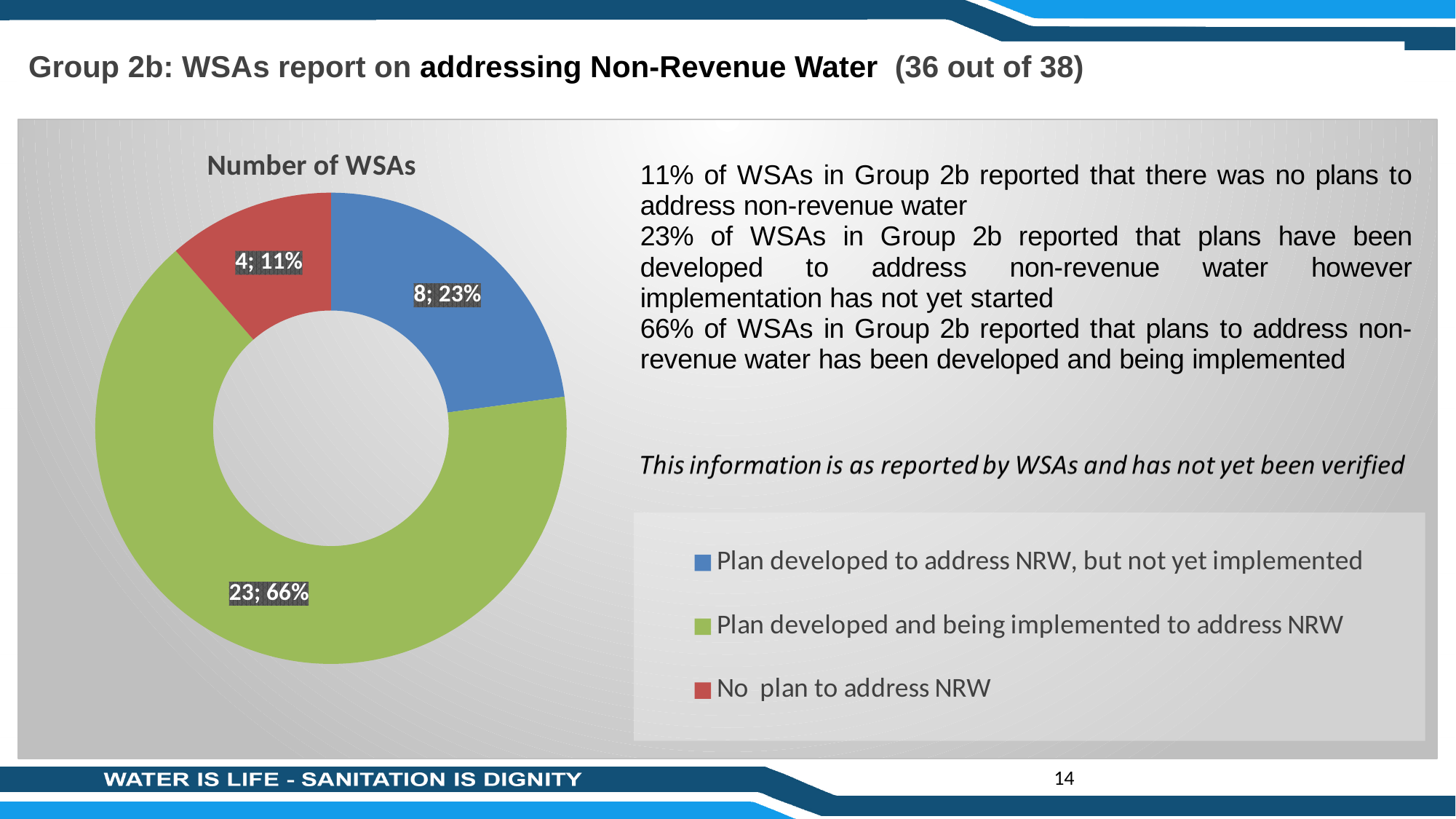
What is the title of the chart? Number of WSAs What is the difference in number of WSAs between 'Plan developed and being implemented to address NRW' and 'Plan developed to address NRW, but not yet implemented'? 15 How many categories does the chart show? 3 What share of the chart does 'No plan to address NRW' represent? 11% How many WSAs reported 'Plan developed to address NRW, but not yet implemented'? 8 What kind of chart is shown on the slide? Doughnut (pie) chart Which is larger: the number of WSAs with 'Plan developed to address NRW, but not yet implemented' or with 'No plan to address NRW'? Plan developed to address NRW, but not yet implemented Which category has the largest slice? Plan developed and being implemented to address NRW Which category has the smallest slice? No plan to address NRW How many WSAs reported 'Plan developed and being implemented to address NRW'? 23 What share of the chart does 'Plan developed and being implemented to address NRW' represent? 66% How many WSAs reported 'No plan to address NRW'? 4